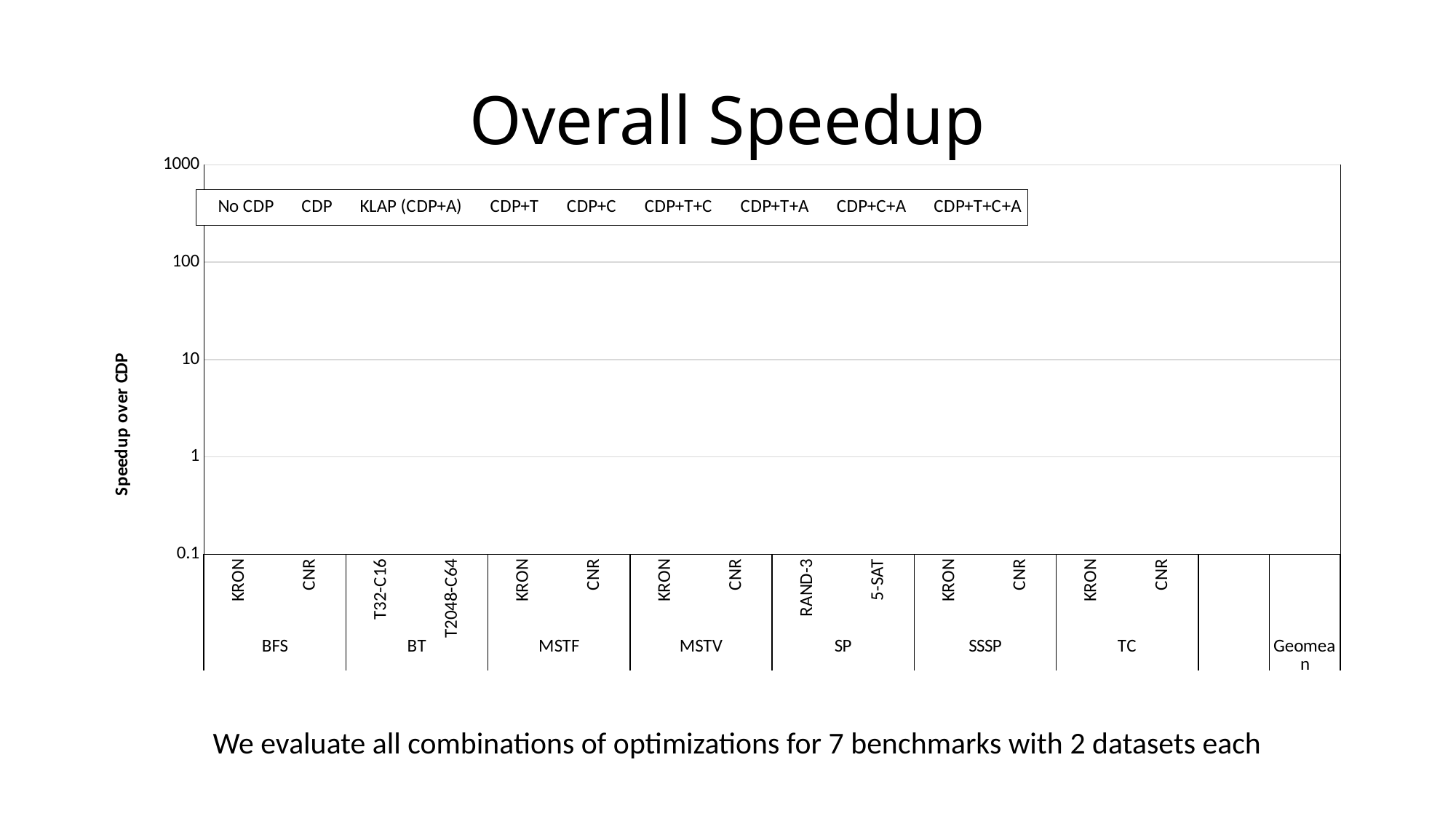
What is the highest tick value shown on the y axis? 1000 How many series does the legend list? 9 Which two datasets are listed under the SP benchmark group? RAND-3 and 5-SAT Which two datasets are listed under the BT benchmark group? T32-C16 and T2048-C64 What is the label of the y axis? Speedup over CDP How many benchmark groups are labelled on the x axis, not counting Geomean? 7 What is the title of the chart? Overall Speedup What is the lowest tick value shown on the y axis? 0.1 How many dataset labels are shown under the BFS group on the x axis? 2